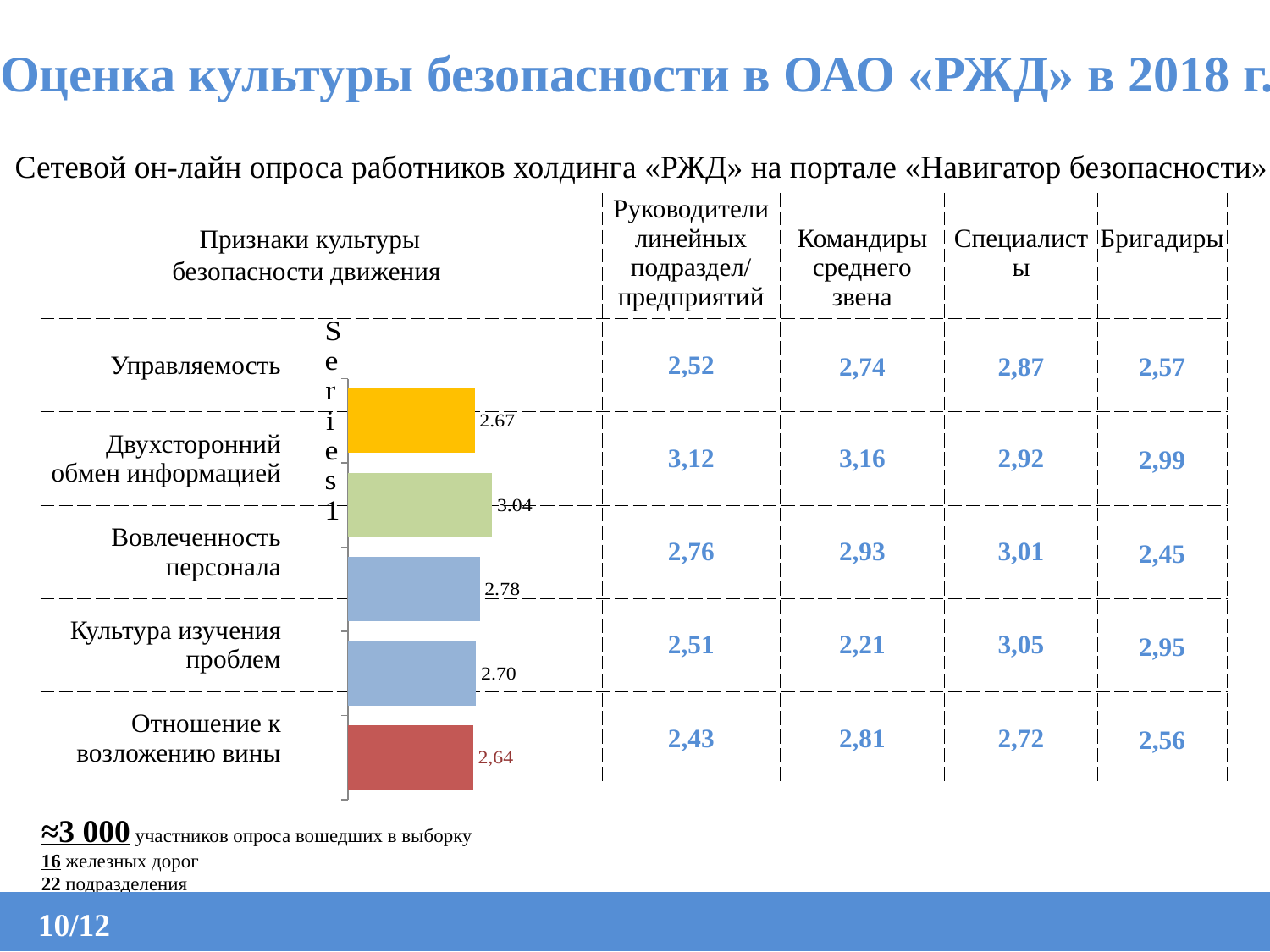
Which is larger: the third bar from the top (2.78) or the fourth bar from the top (2.70)? the third bar (2.78) What value is labelled on the third bar from the top of the chart? 2.78 What kind of chart is shown on the slide? bar chart What is the highest value labelled on the bars in the chart? 3.04 What value is labelled on the yellow (top) bar of the chart? 2.67 What is the difference between the green bar's value (3.04) and the yellow bar's value (2.67)? 0.37 What value is labelled on the green bar of the chart? 3.04 What value is labelled on the red (bottom) bar of the chart? 2,64 What is the lowest value labelled on the bars in the chart? 2,64 What series name is displayed vertically next to the chart? Series 1 What colour is the longest bar in the chart? green How many bars does the chart contain? 5